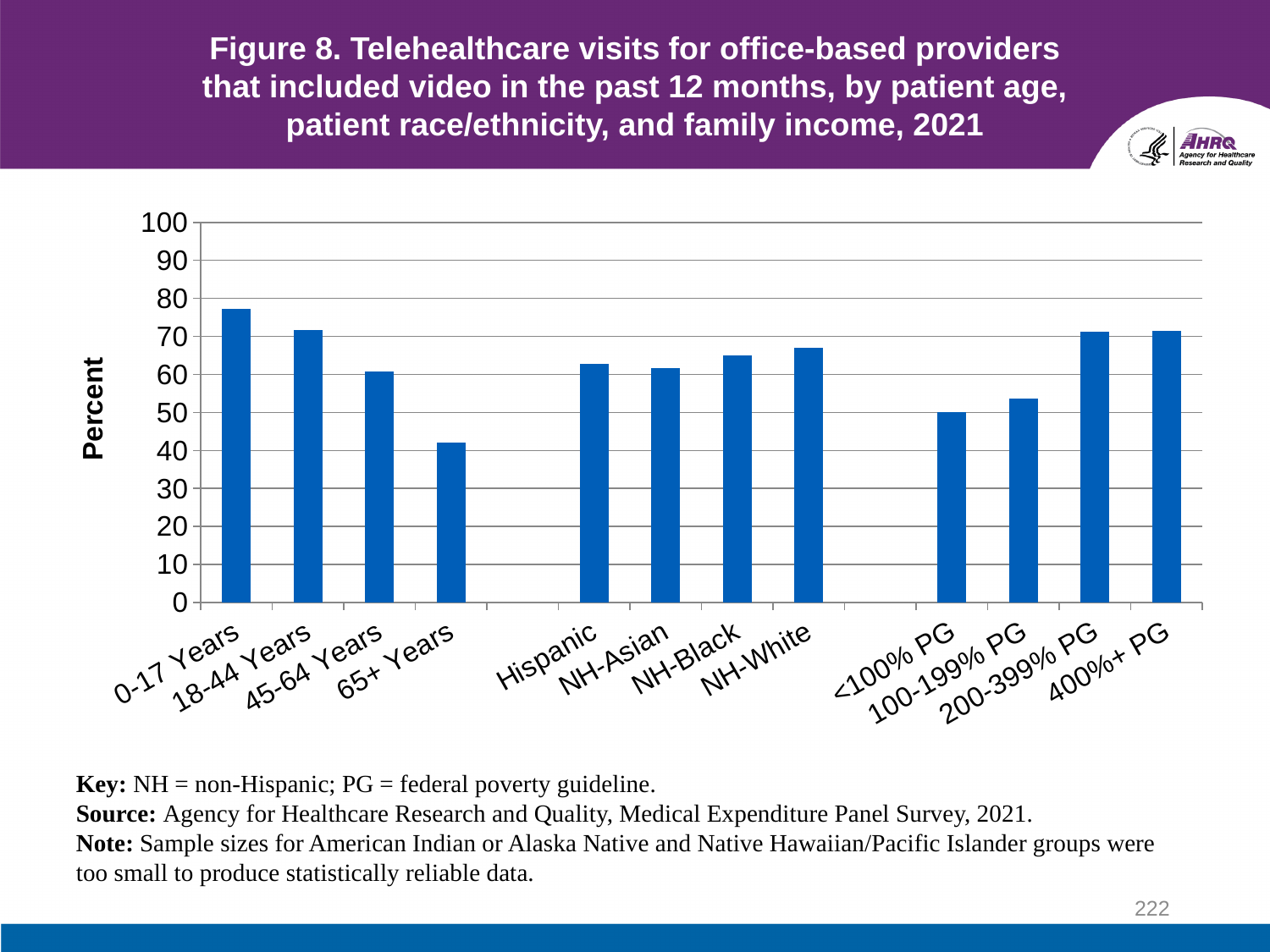
Which is larger, the value for 400%+ PG or the value for <100% PG? 400%+ PG Is the value for 65+ Years greater or less than 50? less Is the value for 100-199% PG greater or less than 60? less Across the four age groups from 0-17 Years to 65+ Years, do the values rise or fall? fall Which category has the highest value in the chart? 0-17 Years Is the value for NH-White greater or less than 70? less What kind of chart is shown on the slide? bar chart How many bars are plotted in the chart? 12 Which category has the lowest value in the chart? 65+ Years Which is larger, the value for NH-White or the value for NH-Asian? NH-White Which is larger, the value for 18-44 Years or the value for 45-64 Years? 18-44 Years